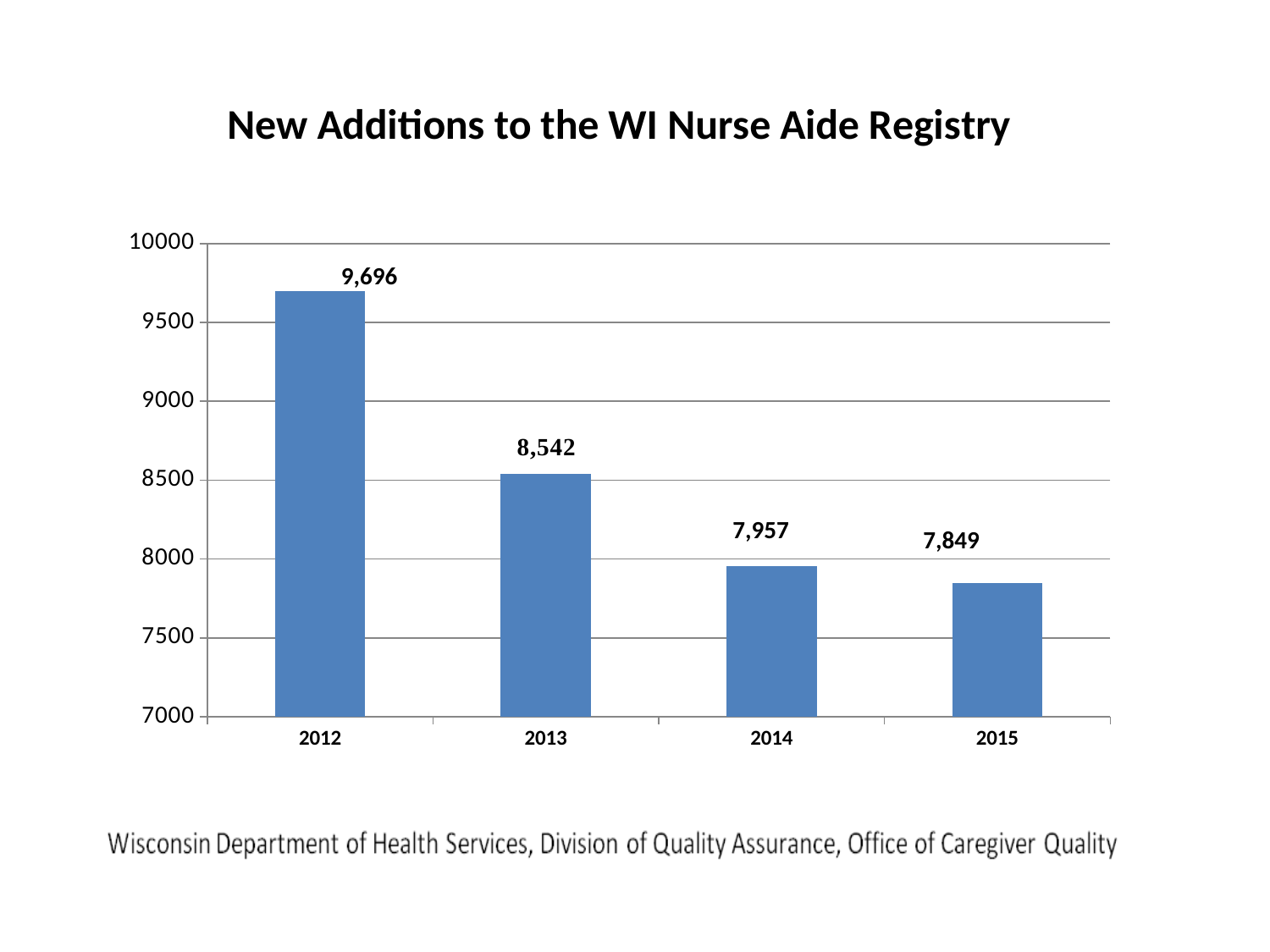
What is the difference between the values for 2014 and 2015? 108 What is the value for 2015? 7,849 Which year has the lowest value? 2015 What is the value for 2012? 9,696 What is the value for 2013? 8,542 What is the difference between the values for 2012 and 2013? 1,154 How many years are shown on the x axis? 4 Which is larger, the value for 2013 or the value for 2014? 2013 Which year has the highest value? 2012 Do the values rise or fall from 2012 to 2015? Fall What kind of chart is this? Bar chart What is the value for 2014? 7,957